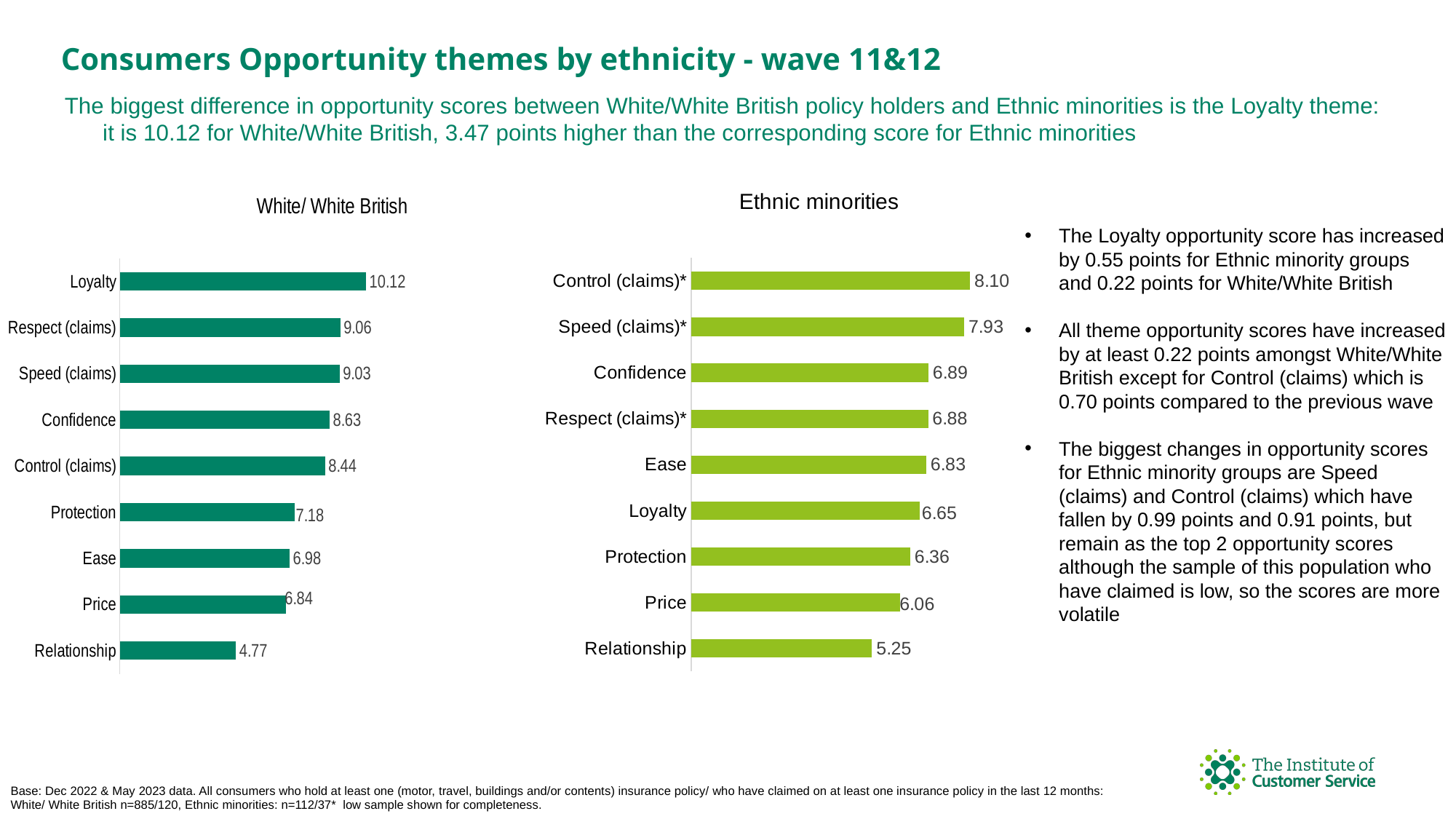
In the Ethnic minorities chart, which category has the highest value? Control (claims)* In the White/ White British chart, what is the value for Loyalty? 10.12 In the Ethnic minorities chart, what is the value for Control (claims)*? 8.10 How many categories are shown in the Ethnic minorities chart? 9 In the White/ White British chart, which category has the lowest value? Relationship In the Ethnic minorities chart, what is the difference between Control (claims)* and Relationship? 2.85 In the White/ White British chart, what is the difference between Loyalty and Respect (claims)? 1.06 What kind of chart is the White/ White British chart? Bar chart In the White/ White British chart, what is the value for Confidence? 8.63 In the Ethnic minorities chart, what is the value for Price? 6.06 What is the title of the chart on the left? White/ White British In the White/ White British chart, which is larger: Protection or Ease? Protection